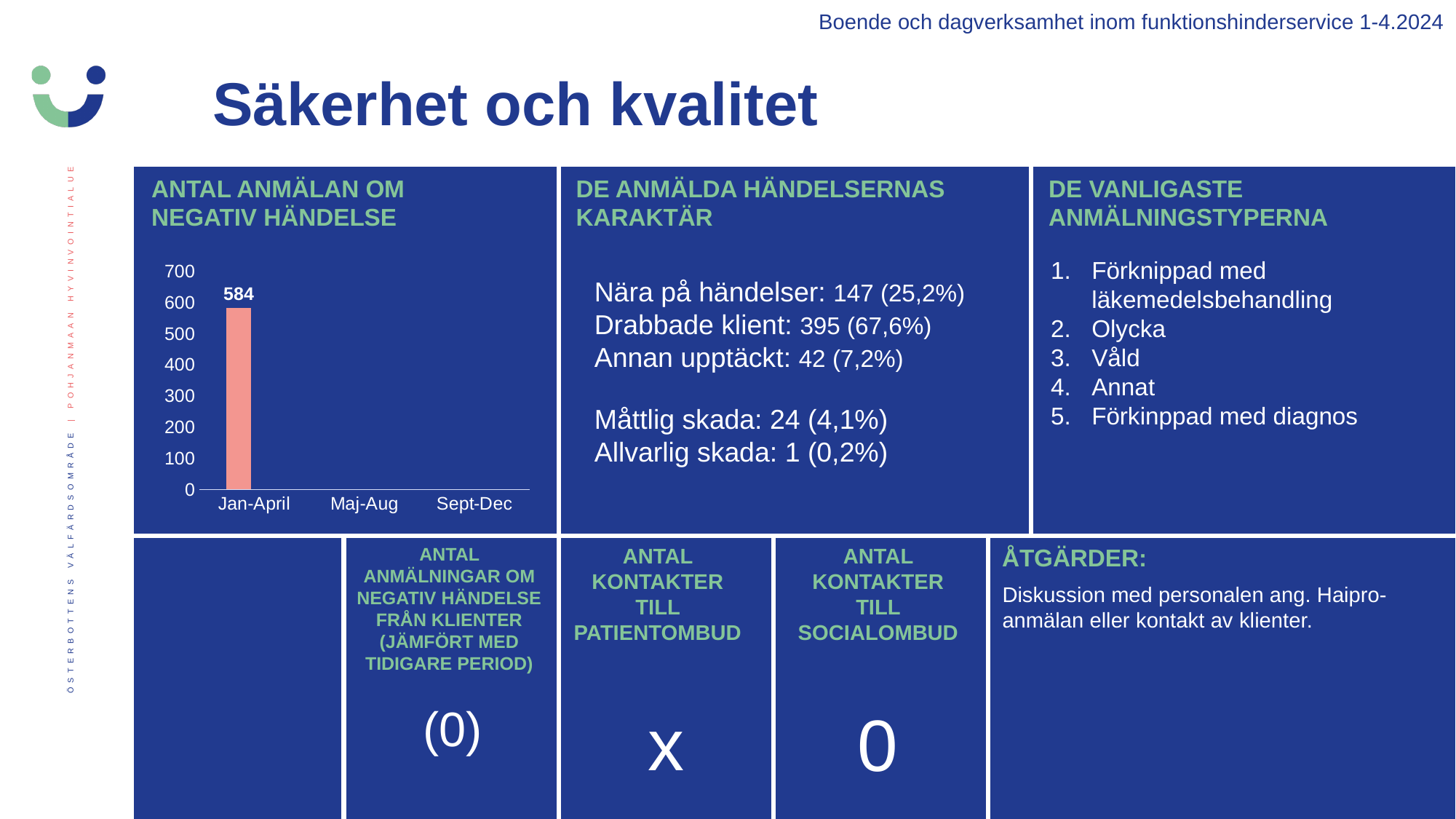
What kind of chart is shown on the slide? bar chart Is the value for Jan-April greater or less than 600? less Which category has the highest value in the chart? Jan-April Which category is listed last on the x axis of the chart? Sept-Dec What is the value for Jan-April in the chart? 584 Is the value for Jan-April greater or less than 500? greater What is the title of the chart? ANTAL ANMÄLAN OM NEGATIV HÄNDELSE What is the highest tick value shown on the y axis of the chart? 700 How many categories are shown on the x axis of the chart? 3